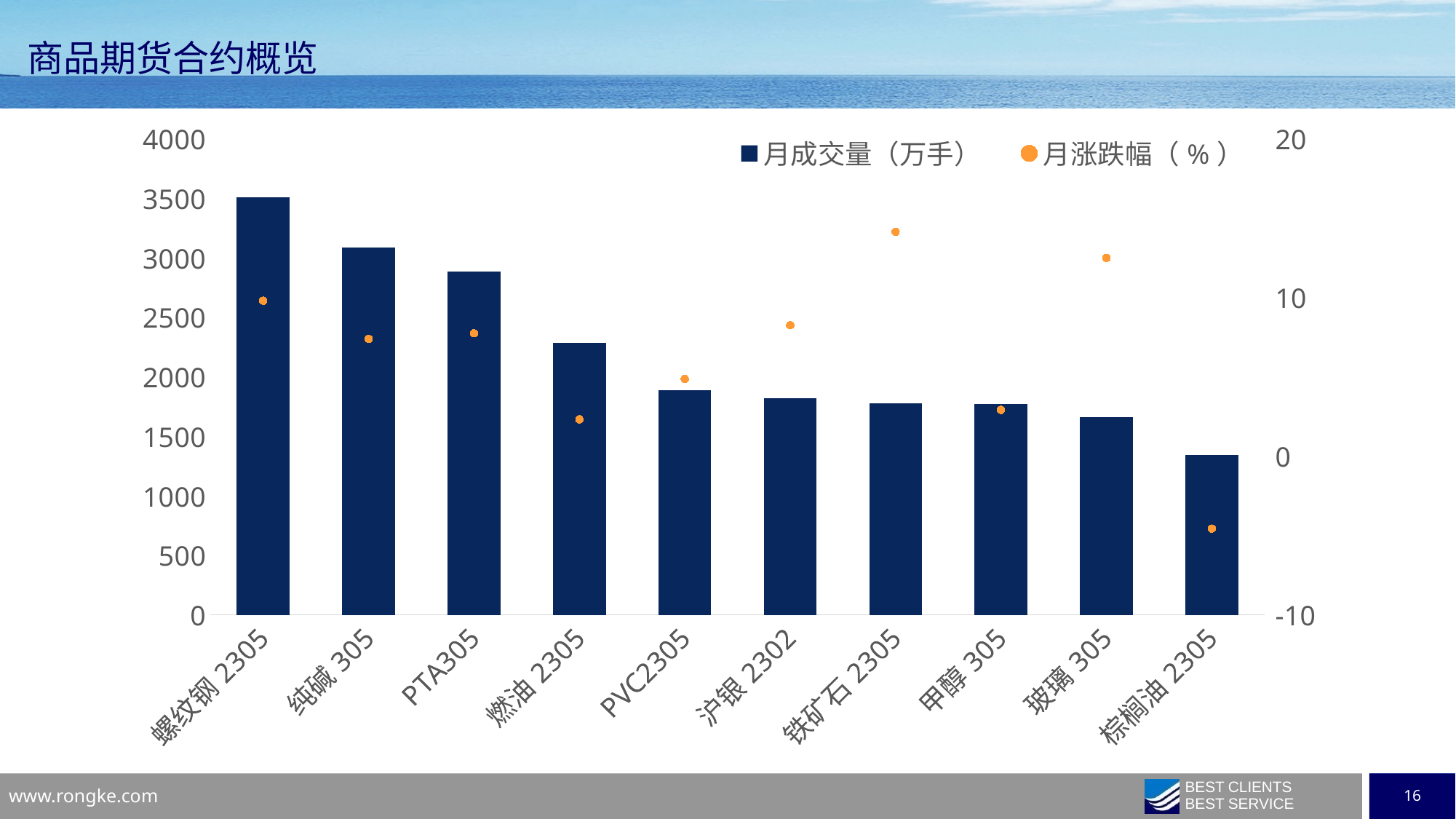
Which contract has the highest 月涨跌幅（%）? 铁矿石 2305 How many contract categories are shown on the x axis? 10 Which has a larger 月成交量（万手）, 纯碱 305 or 燃油 2305? 纯碱 305 Is the 月涨跌幅（%） for 棕榈油 2305 greater or less than 0? less Is the 月成交量（万手） for 棕榈油 2305 greater or less than 1500? less Do the 月成交量（万手） bars rise or fall from left to right along the x axis? fall Which contract has the lowest 月涨跌幅（%）? 棕榈油 2305 Which contract has the lowest 月成交量（万手）? 棕榈油 2305 What kind of chart is shown on the slide? A bar chart combined with a dot (scatter) series Which contract has the highest 月成交量（万手）? 螺纹钢 2305 How many series does the legend list? 2